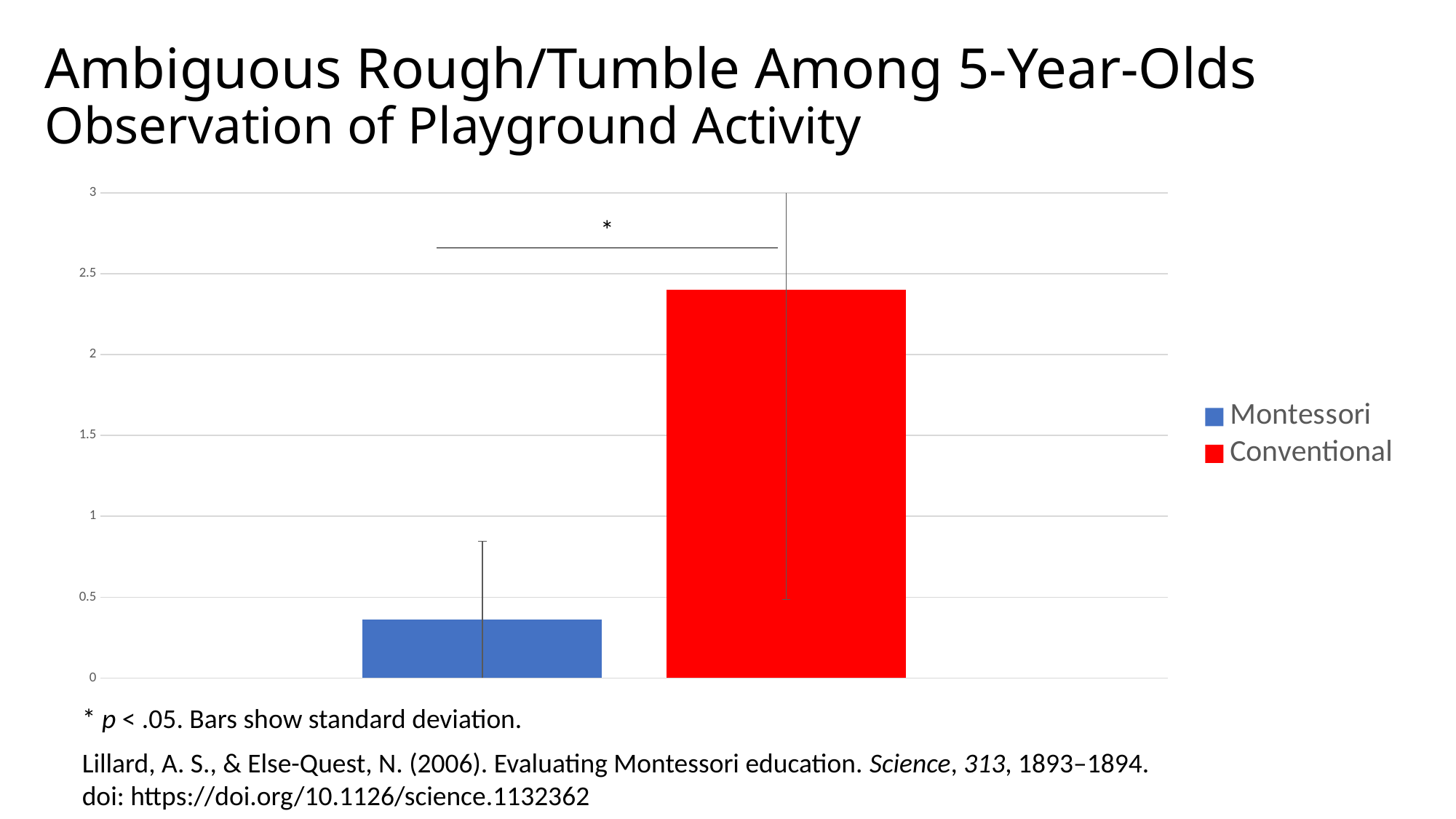
Is the value for Montessori larger or smaller than the value for Conventional? smaller Is the value for Conventional greater or less than 2? greater What kind of chart is shown on the slide? bar chart How many bars are plotted in the chart? 2 Is the value for Conventional greater or less than 1.5? greater Which group has the higher bar, Montessori or Conventional? Conventional How many series does the legend list? 2 According to the footnote, what do the error bars show? standard deviation What colour is the Conventional bar? red Is the value for Montessori greater or less than 0.5? less Which group has the lowest bar? Montessori